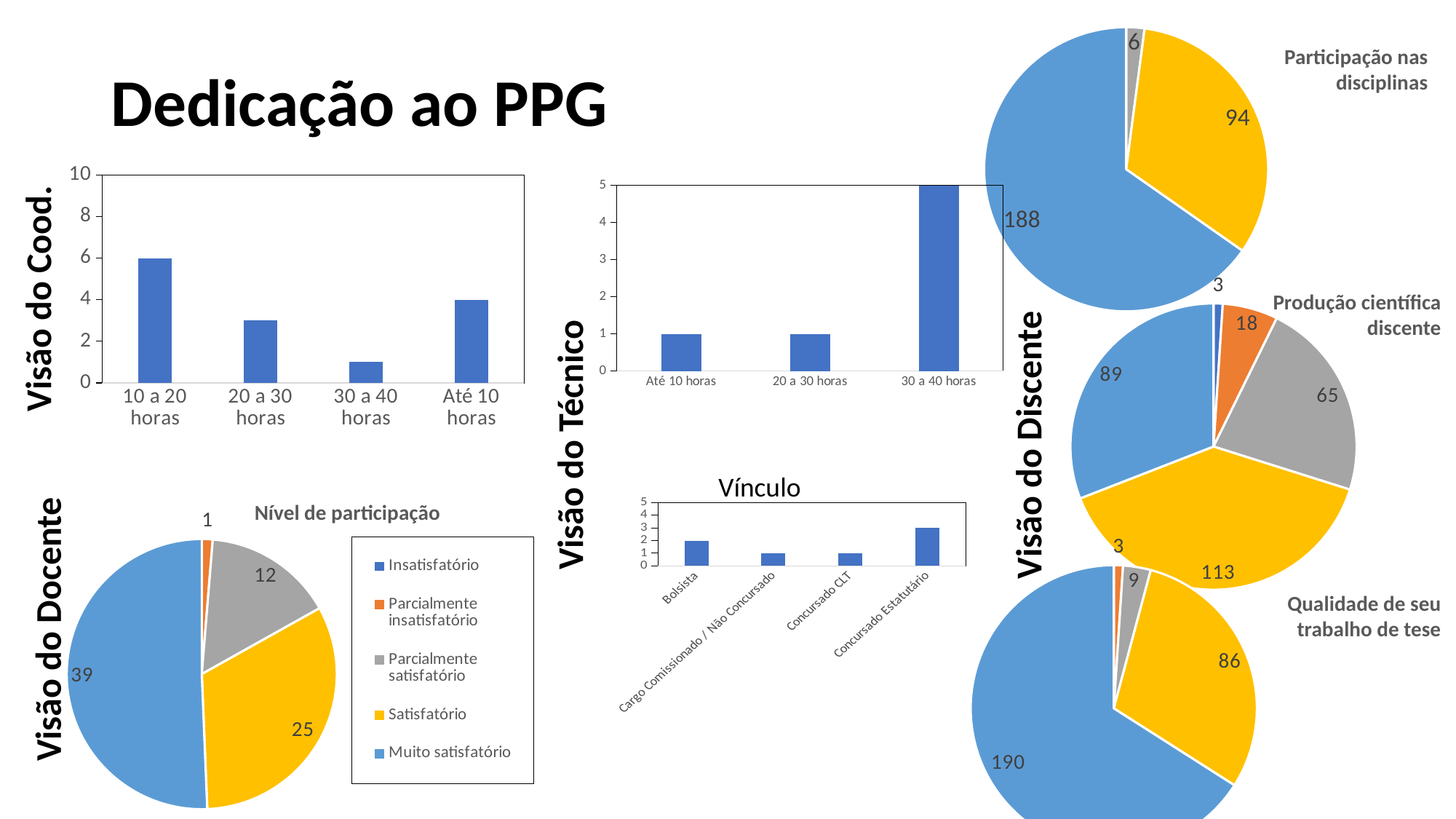
In the 'Visão do Cood.' bar chart, which category has the lowest value? 30 a 40 horas In the 'Vínculo' bar chart, which category has the highest value? Concursado Estatutário How many entries does the legend of the 'Nível de participação' pie chart list? 5 In the 'Visão do Técnico' bar chart with hour categories, what is the value for '30 a 40 horas'? 5 In the 'Visão do Cood.' bar chart, what is the value for '10 a 20 horas'? 6 In the 'Nível de participação' pie chart, what is the value of the 'Satisfatório' slice? 25 In the 'Produção científica discente' pie chart, which is larger: the slice labelled 89 or the slice labelled 65? 89 What kind of chart is the 'Vínculo' chart? bar chart In the 'Participação nas disciplinas' pie chart, what is the difference between the largest slice and the second largest slice? 94 In the 'Qualidade de seu trabalho de tese' pie chart, what is the total of all slices? 288 In the 'Visão do Cood.' bar chart, is the value for '20 a 30 horas' greater or less than 2? greater In the 'Vínculo' bar chart, how many categories are shown? 4